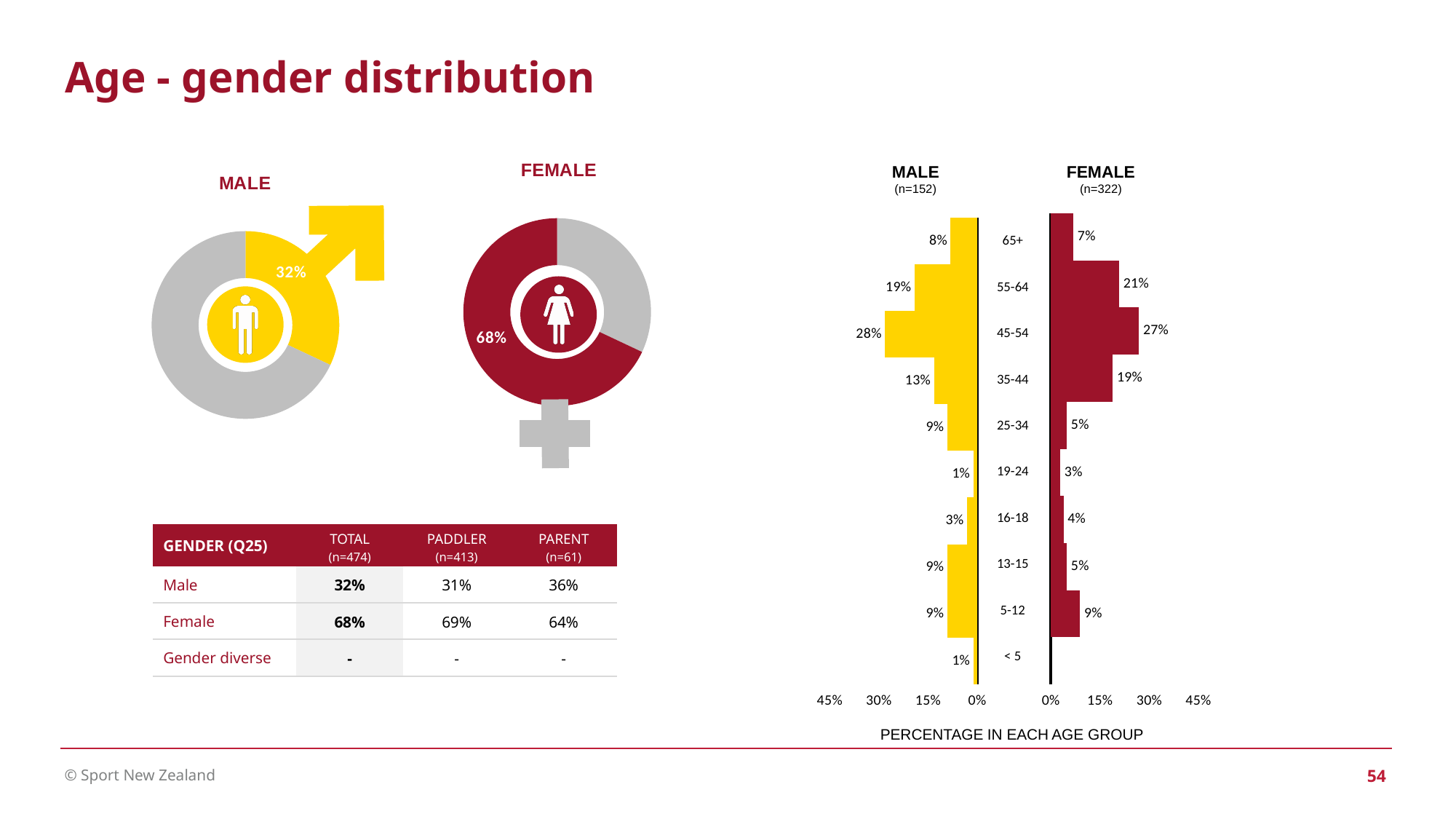
In the Male donut chart on the left, what percentage is highlighted? 32% In the age group bar chart on the right, what percentage of males are aged 45-54? 28% In the age group bar chart on the right, is the male percentage or the female percentage larger for the 25-34 age group? Male In the age group bar chart on the right, what is the difference between the male and female percentages for the 35-44 age group? 6% In the Female donut chart, what percentage is highlighted? 68% In the age group bar chart on the right, which age group has the highest percentage of males? 45-54 In the age group bar chart on the right, which age group has the highest percentage of females? 45-54 What kind of chart is the age group chart on the right of the slide? Bar chart In the age group bar chart on the right, is the female value for 55-64 greater or less than 15%? greater How many age groups are shown in the age group bar chart on the right? 10 In the age group bar chart on the right, what percentage of females are aged 35-44? 19% What is the sample size (n) for females shown above the age group bar chart on the right? n=322